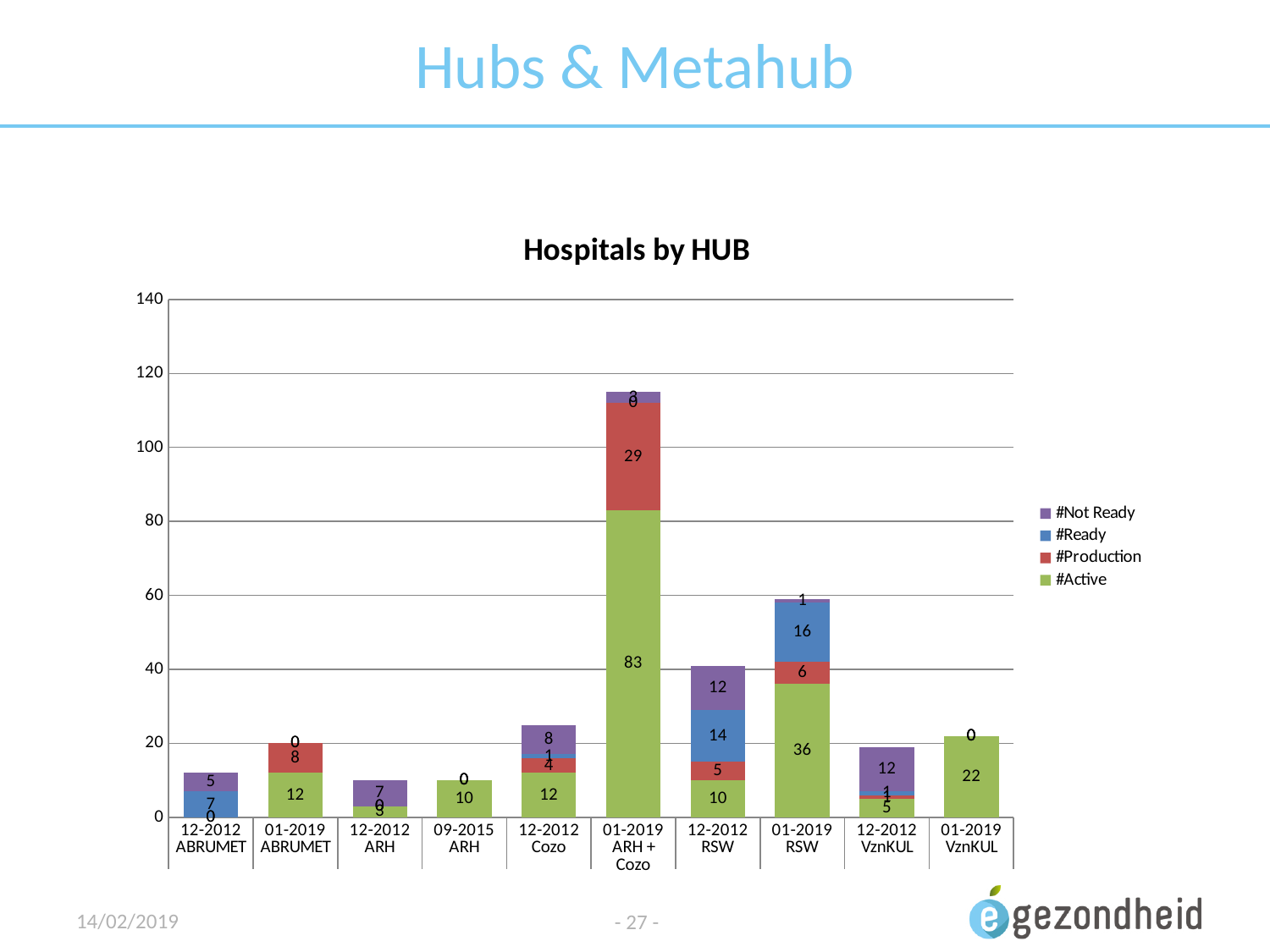
What is the #Not Ready value for 12-2012 RSW? 12 Which category has the tallest stacked bar? 01-2019 ARH + Cozo What is the #Active value for 01-2019 ARH + Cozo? 83 What is the #Ready value for 01-2019 RSW? 16 Is the total stacked bar for 01-2019 RSW greater or less than 40? greater What is the title of the chart? Hospitals by HUB What is the difference between the #Active values for 01-2019 RSW and 12-2012 RSW? 26 What is the total of the stacked bar for 12-2012 RSW? 41 What is the #Production value for 01-2019 ARH + Cozo? 29 How many series does the legend list? 4 What kind of chart is shown on the slide? bar chart How many categories are shown on the x axis? 10